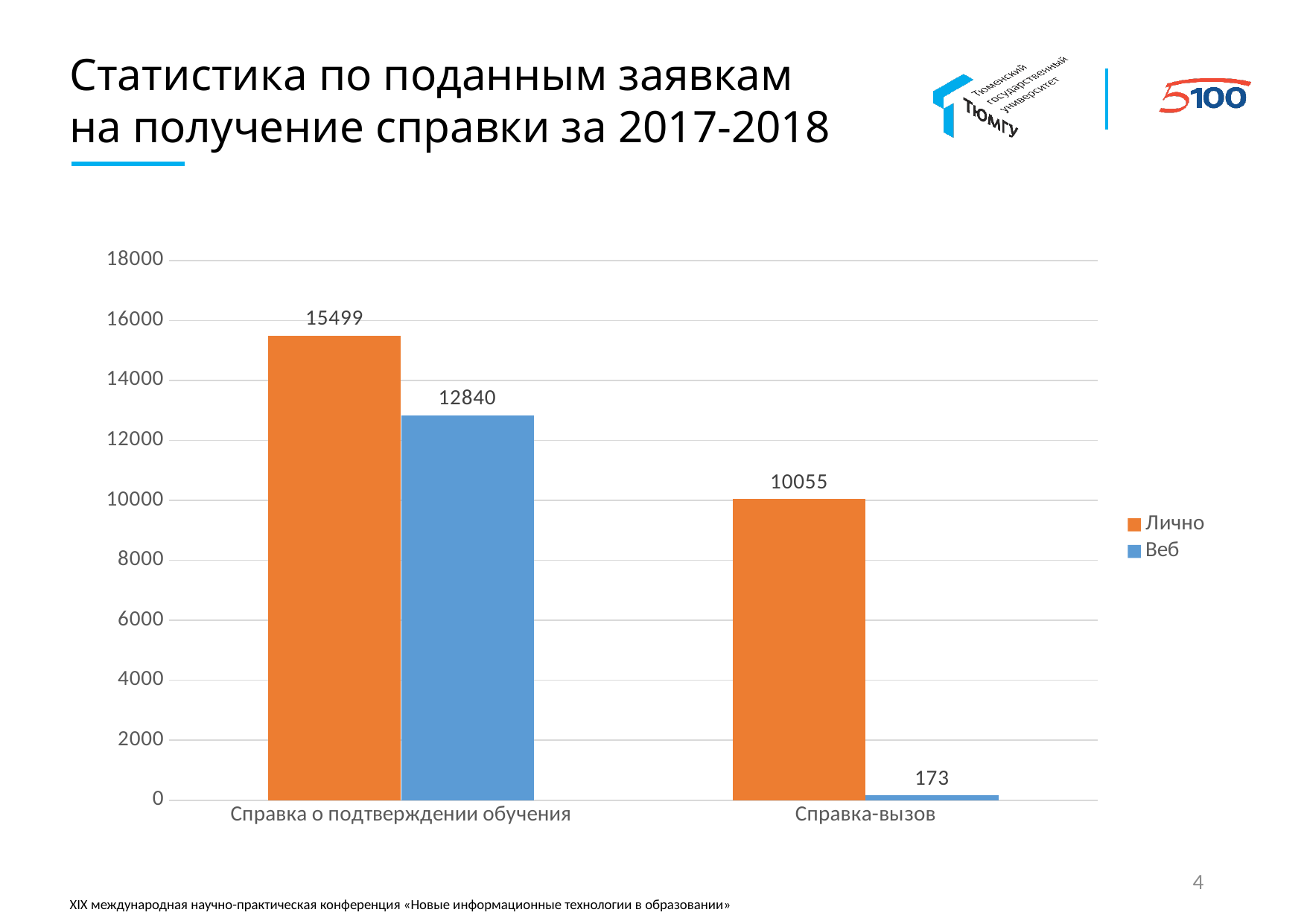
Which is larger for Справка-вызов: Лично or Веб? Лично What kind of chart is shown on the slide? Bar chart What is the value for Лично for Справка о подтверждении обучения? 15499 How many categories are shown on the x axis? 2 What is the value for Лично for Справка-вызов? 10055 What is the value for Веб for Справка-вызов? 173 What is the value for Веб for Справка о подтверждении обучения? 12840 Which bar has the lowest value on the chart? Веб, Справка-вызов What is the difference between Лично and Веб for Справка-вызов? 9882 How many series does the legend list? 2 Which bar has the highest value on the chart? Лично, Справка о подтверждении обучения What is the difference between Лично and Веб for Справка о подтверждении обучения? 2659